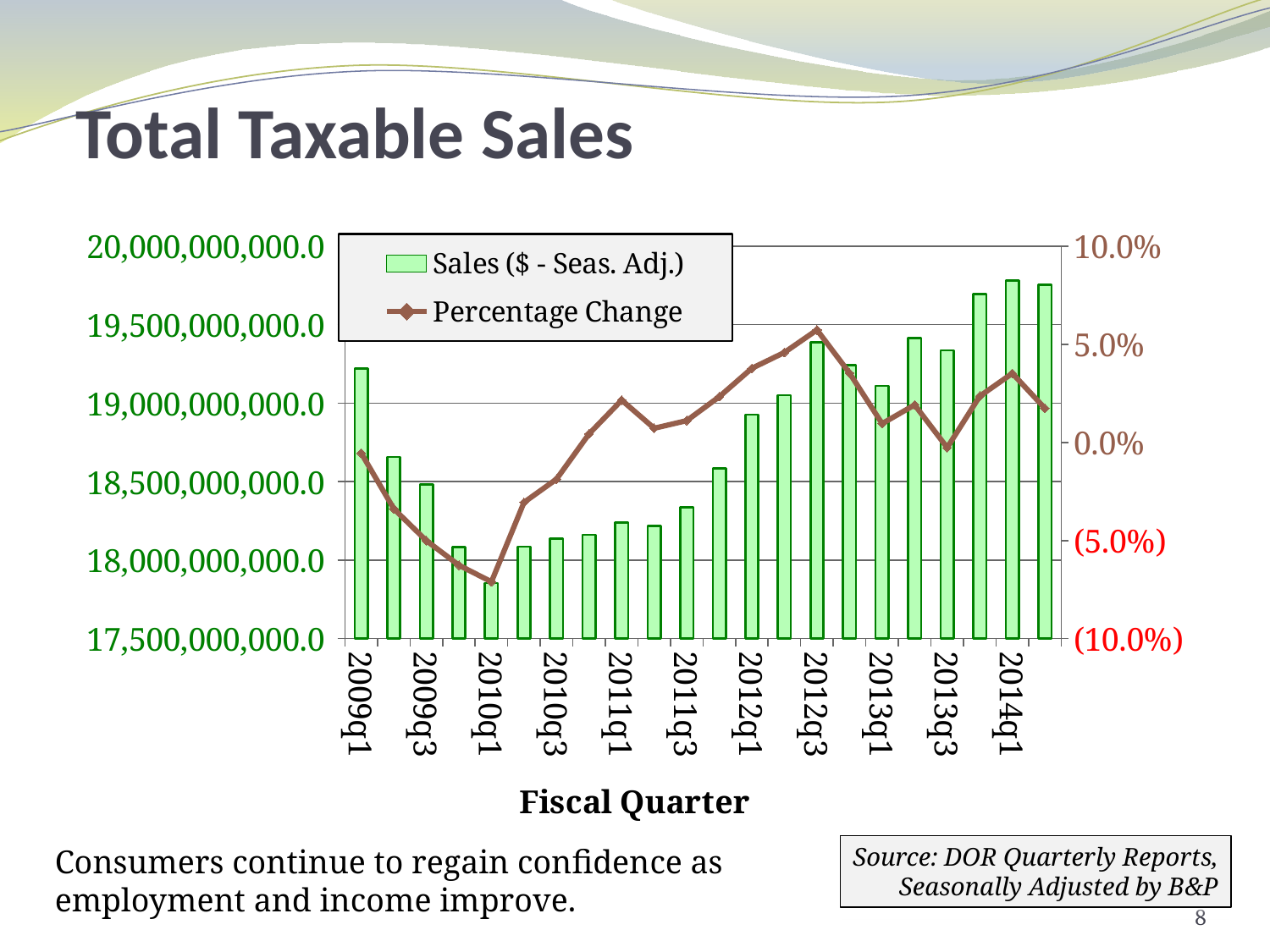
What is the title of the x axis? Fiscal Quarter What kind of chart is shown on the slide? A bar chart combined with a line chart Which has the larger Sales value, 2009q1 or 2009q3? 2009q1 Which fiscal quarter has the lowest Sales bar? 2010q1 Is the Percentage Change value for 2010q1 greater or less than (5.0%)? less What are the two series named in the legend? Sales ($ - Seas. Adj.) and Percentage Change Do the Sales bars rise or fall from 2009q1 to 2010q1? fall Does the Percentage Change line rise or fall from 2010q1 to 2012q3? rise Is the Sales value for 2009q1 greater or less than 19,000,000,000.0? greater Is the Sales value for 2010q1 greater or less than 18,000,000,000.0? less How many series does the legend list? 2